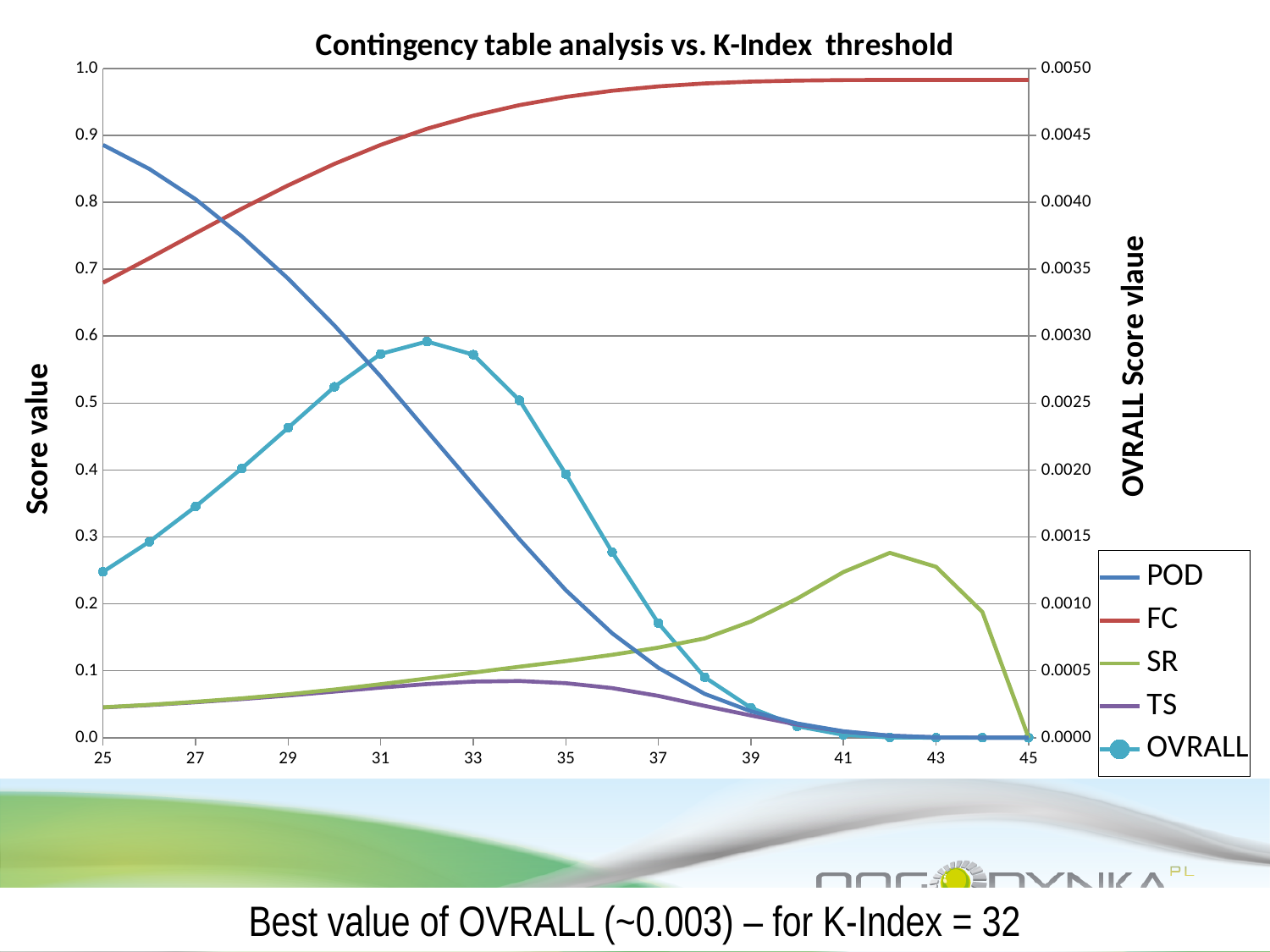
At K-Index 35, which series has the higher value, POD or FC? FC At which K-Index value does the OVRALL series reach its highest point? 32 How many series does the legend list? 5 What is the title of the chart? Contingency table analysis vs. K-Index threshold At K-Index 25, which series has the higher value, POD or FC? POD Is the value of POD at K-Index 25 greater or less than 0.8? greater Does the POD series rise or fall as the K-Index threshold increases from 25 to 45? fall Is the value of FC at K-Index 25 greater or less than 0.7? less Is the peak value of SR (around K-Index 42) greater or less than 0.2? greater What kind of chart is shown on the slide? line chart What is the label of the right-hand vertical axis? OVRALL Score vlaue Does the FC series rise or fall as the K-Index threshold increases from 25 to 45? rise